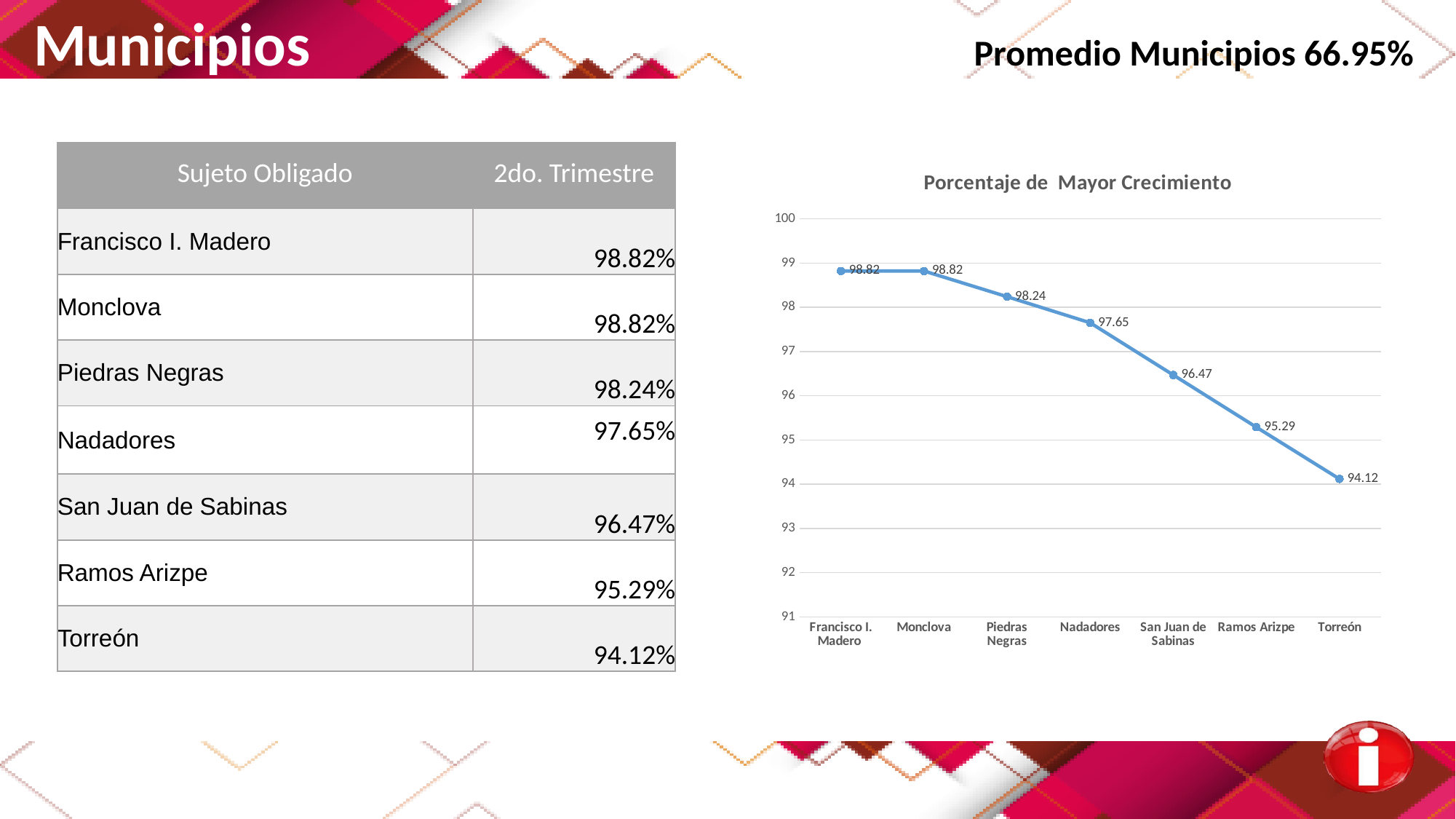
What is the value for Torreón in the chart? 94.12 Which is larger, the value for Nadadores or the value for Ramos Arizpe? Nadadores What is the value for San Juan de Sabinas in the chart? 96.47 What kind of chart is shown on the slide? line chart Is the value for San Juan de Sabinas greater or less than 97? less Do the values rise or fall from left to right along the x axis? fall Which municipality has the lowest value in the chart? Torreón What is the title of the chart? Porcentaje de Mayor Crecimiento What is the difference between the values for Monclova and Torreón? 4.70 How many municipalities are plotted in the chart? 7 What is the difference between the values for Piedras Negras and Ramos Arizpe? 2.95 What is the value for Nadadores in the chart? 97.65